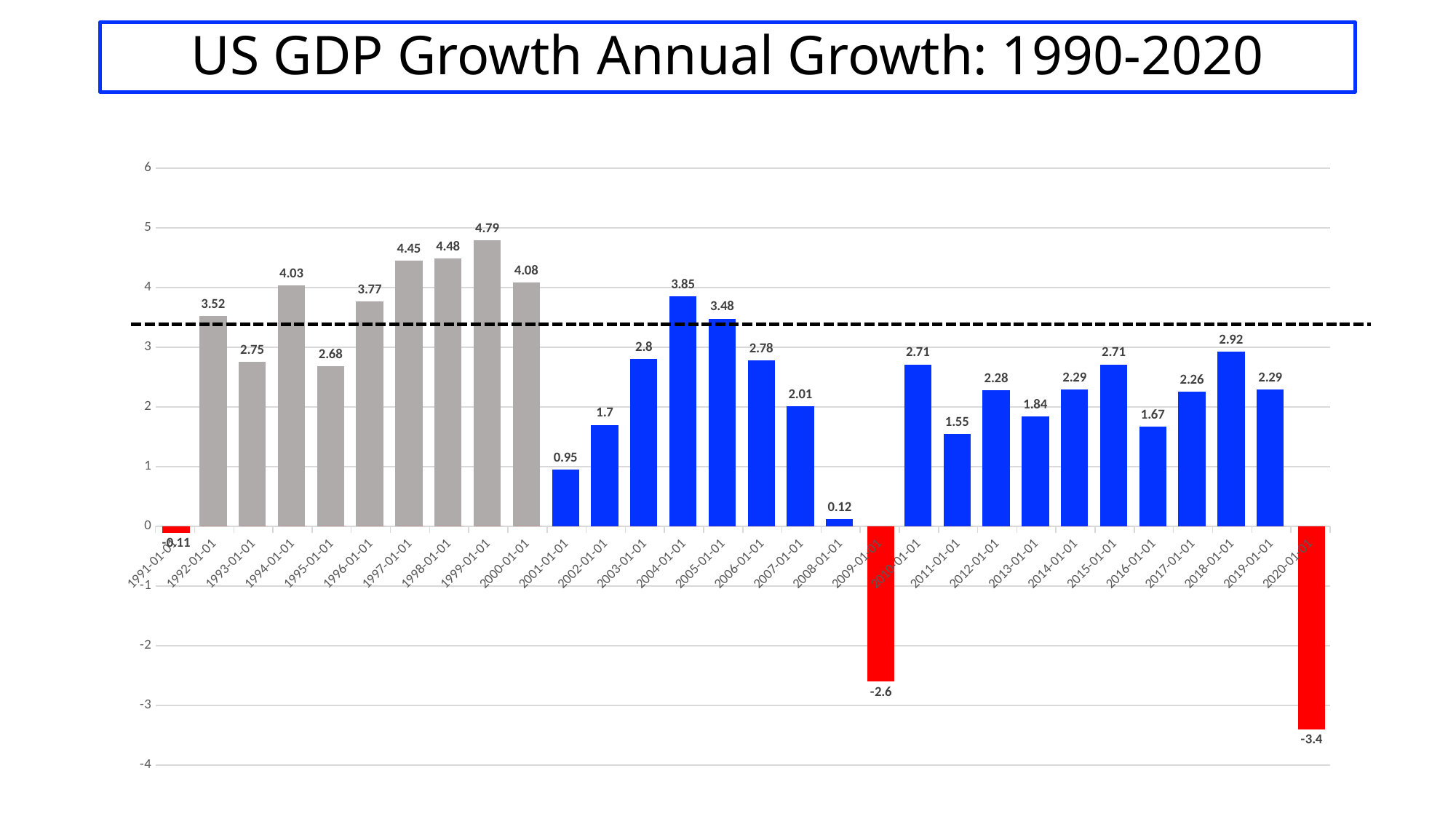
What is the value for 2009-01-01? -2.6 How many bars are plotted in the chart? 30 Which is larger, the value for 2011-01-01 or the value for 2013-01-01? 2013-01-01 What colour are the bars with negative values? Red What is the difference between the values for 1998-01-01 and 1997-01-01? 0.03 What is the value for 2018-01-01? 2.92 Which year has the highest value? 1999-01-01 What is the value for 2008-01-01? 0.12 What is the value for 1999-01-01? 4.79 What is the difference between the values for 2004-01-01 and 2001-01-01? 2.9 What kind of chart is shown on the slide? Bar chart Which year has the lowest value? 2020-01-01